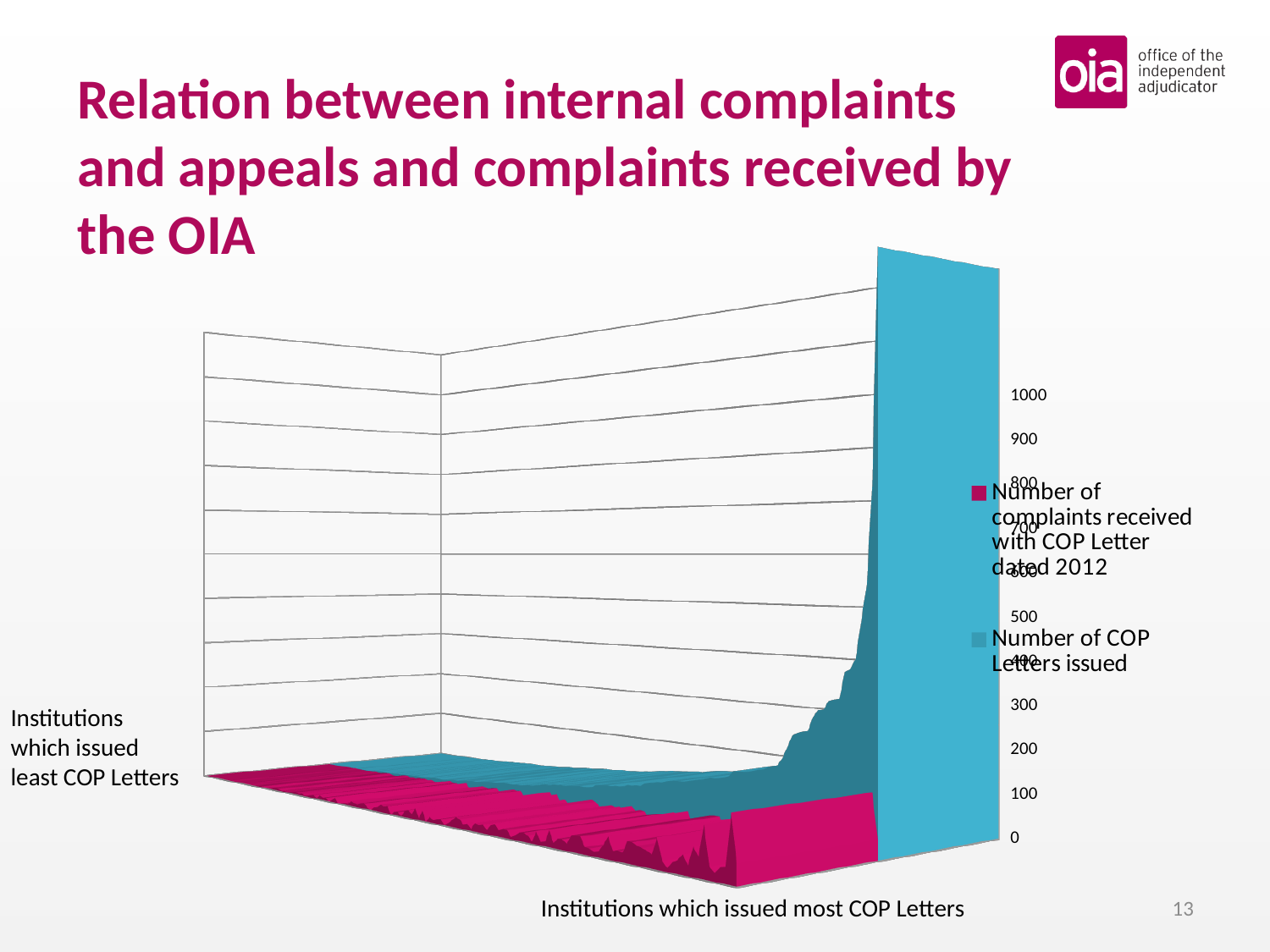
How many series does the chart's legend list? 2 Do the values for Number of COP Letters issued rise or fall moving from the institutions which issued least COP Letters to those which issued most? Rise What kind of chart is shown on the slide? Area chart Which series is shown in blue on the chart? Number of COP Letters issued Is the value for Number of COP Letters issued at the institutions which issued least COP Letters greater or less than 200? less Is the highest value for Number of COP Letters issued greater or less than 1000? greater At the institutions which issued most COP Letters, which series has the larger value: Number of COP Letters issued or Number of complaints received with COP Letter dated 2012? Number of COP Letters issued Which series is shown in magenta on the chart? Number of complaints received with COP Letter dated 2012